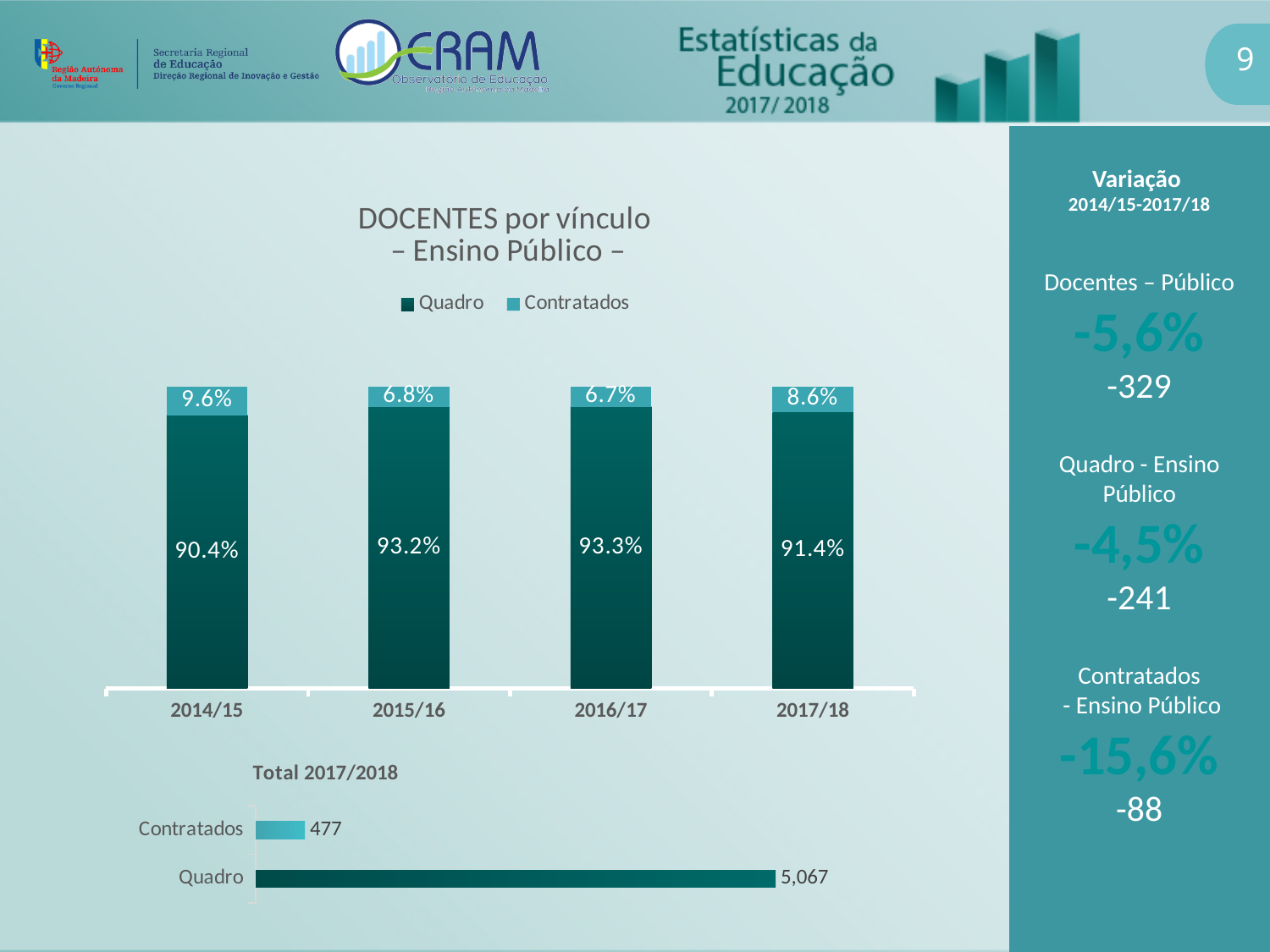
In the 'DOCENTES por vínculo – Ensino Público' chart, which year has the highest Quadro share? 2016/17 How many years are shown on the x axis of the 'DOCENTES por vínculo – Ensino Público' chart? 4 What kind of chart is the 'DOCENTES por vínculo – Ensino Público' chart? Stacked bar chart In the 'DOCENTES por vínculo – Ensino Público' chart, what is the Contratados value for 2017/18? 8.6% In the 'Total 2017/2018' chart, what is the value for Contratados? 477 In the 'Total 2017/2018' chart, what is the difference between the Quadro and Contratados values? 4,590 In the 'Total 2017/2018' chart, what is the value for Quadro? 5,067 How many series does the legend of the 'DOCENTES por vínculo – Ensino Público' chart list? 2 In the 'DOCENTES por vínculo – Ensino Público' chart, is the Quadro share larger in 2015/16 or in 2017/18? 2015/16 In the 'DOCENTES por vínculo – Ensino Público' chart, what is the Quadro value for 2014/15? 90.4% In the 'DOCENTES por vínculo – Ensino Público' chart, which year has the lowest Contratados share? 2016/17 In the 'DOCENTES por vínculo – Ensino Público' chart, what is the difference between the Contratados values for 2014/15 and 2017/18? 1.0%